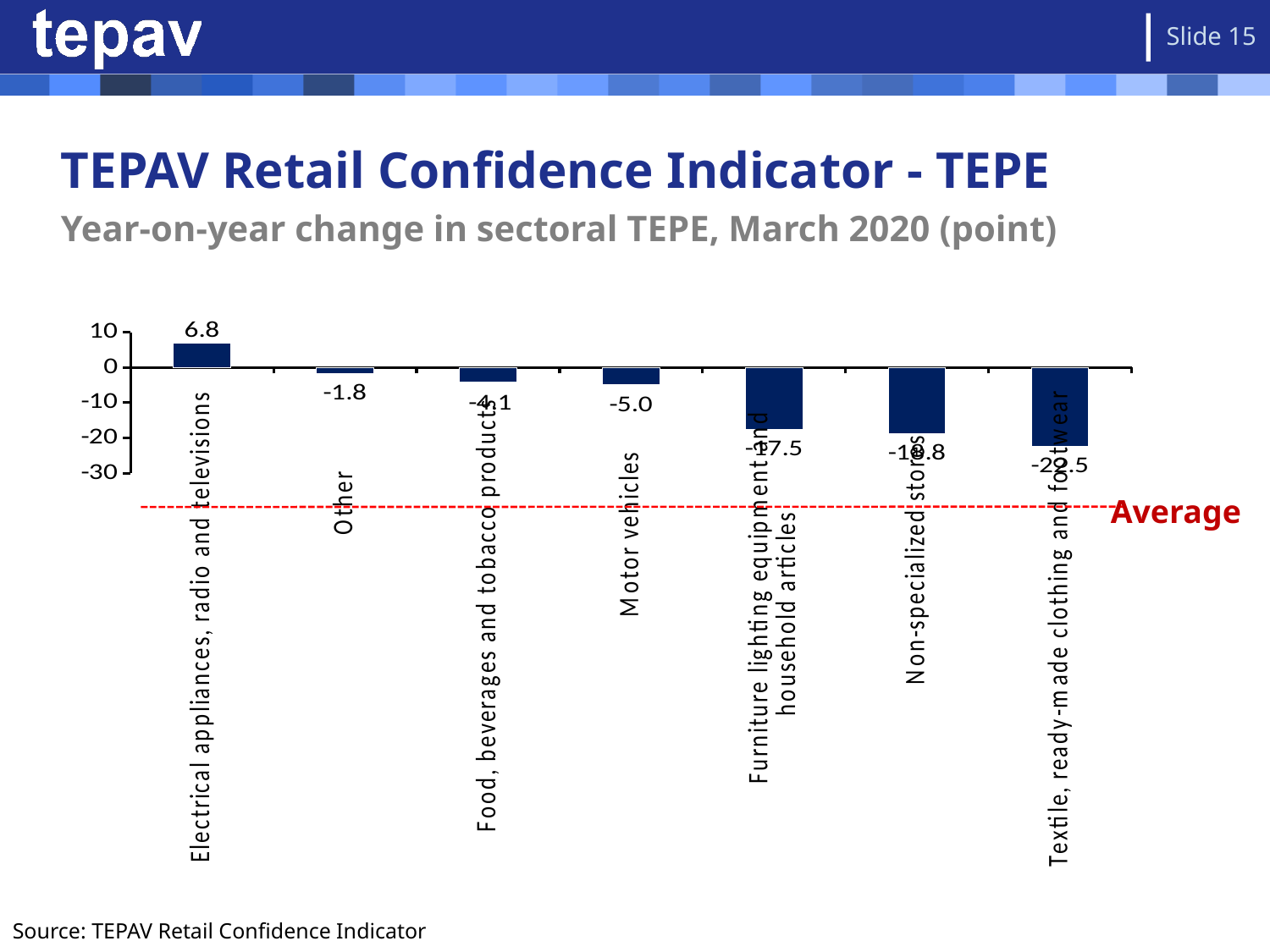
What is the difference between the values for Electrical appliances, radio and televisions and Motor vehicles? 11.8 What does the red dashed line on the chart represent? Average What is the year-on-year change for Textile, ready-made clothing and footwear? -22.5 How many sectors are plotted in the chart? 7 Which sector has the highest year-on-year change in TEPE? Electrical appliances, radio and televisions What is the year-on-year change for Motor vehicles? -5.0 Which has the larger value, Other or Motor vehicles? Other Which sector has the lowest year-on-year change in TEPE? Textile, ready-made clothing and footwear What type of chart is shown on the slide? bar chart Is the value for Non-specialized stores greater or less than -10? less What is the year-on-year change for Electrical appliances, radio and televisions? 6.8 What is the year-on-year change for Other? -1.8